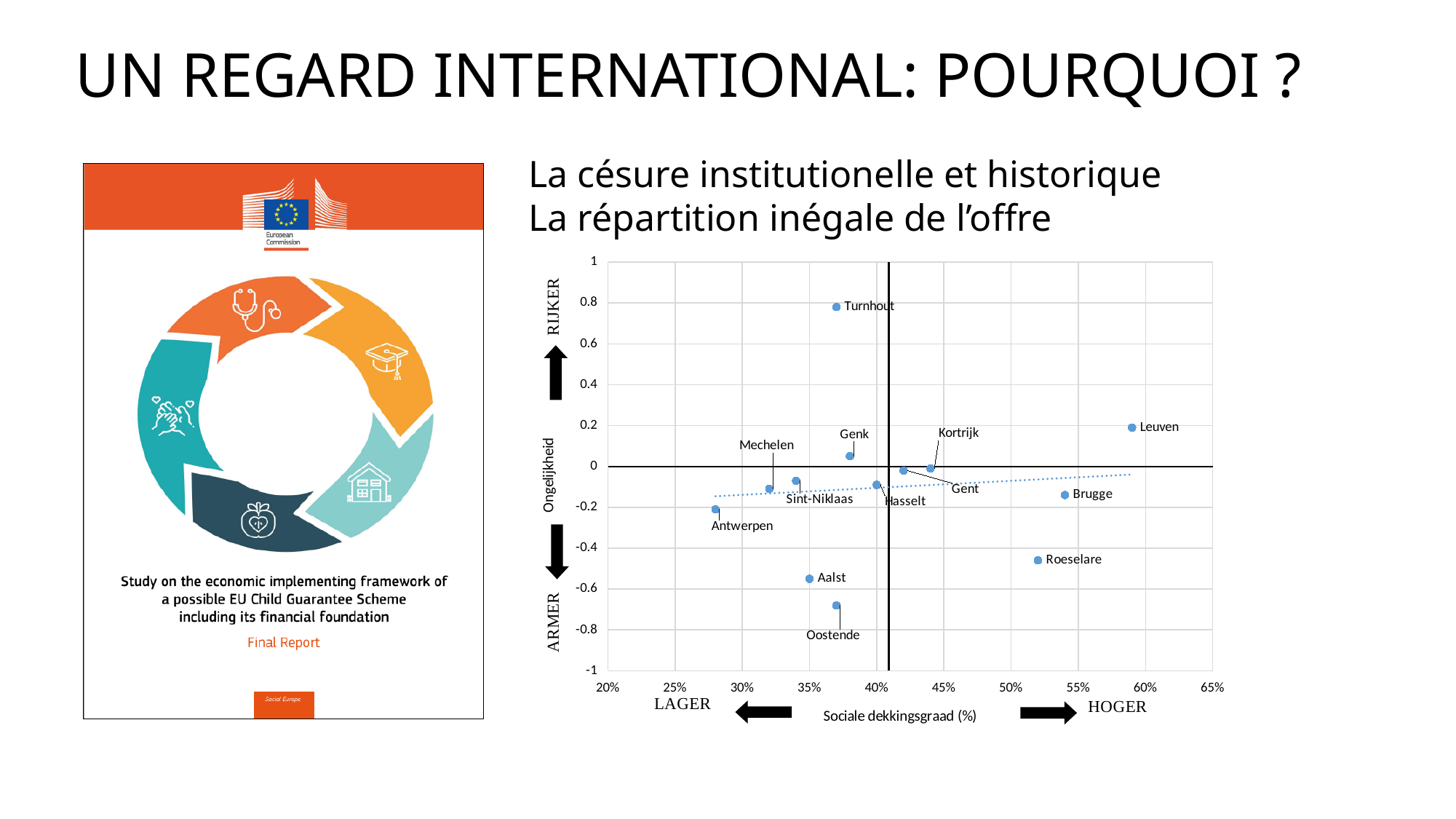
Is the vertical-axis value for Roeselare greater or less than -0.4? less Which city has a higher vertical-axis value, Aalst or Leuven? Leuven Which city has the lowest value on the vertical (Ongelijkheid) axis? Oostende How many cities are plotted on the chart? 13 Which city has the highest Sociale dekkingsgraad (furthest right on the x axis)? Leuven What is the label of the horizontal axis of the chart? Sociale dekkingsgraad (%) Is the Sociale dekkingsgraad for Leuven greater or less than 55%? greater Is the vertical-axis value for Turnhout greater or less than 0.6? greater Which city has the lowest Sociale dekkingsgraad (furthest left on the x axis)? Antwerpen What kind of chart is shown on the slide? scatter chart Which city has the highest value on the vertical (Ongelijkheid) axis? Turnhout